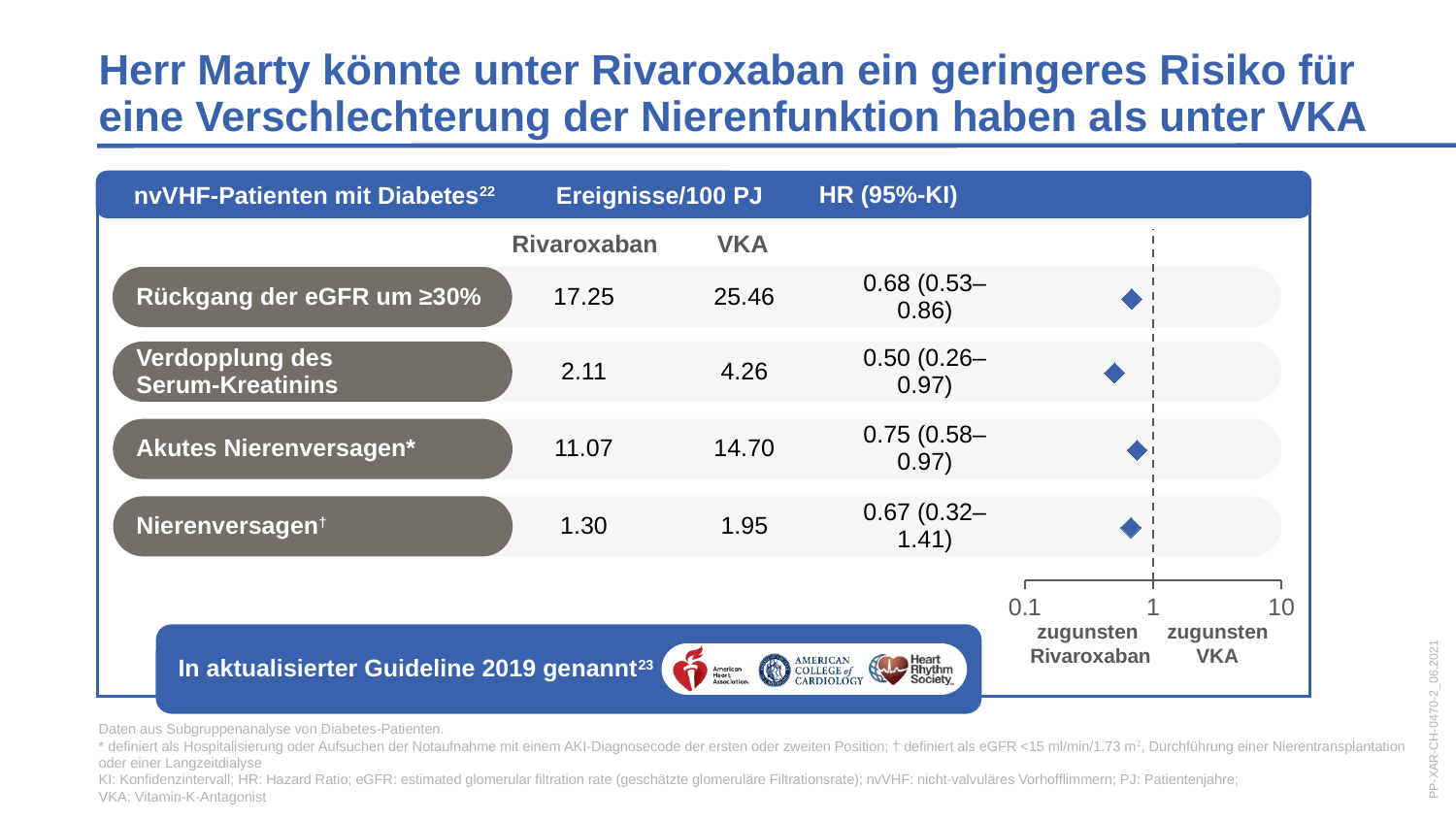
For "Nierenversagen†", which treatment has the higher event rate per 100 PJ, Rivaroxaban or VKA? VKA Which side of the forest plot axis is labelled "zugunsten Rivaroxaban", the left or the right? left Which outcome has the highest hazard ratio in the forest plot? Akutes Nierenversagen* Which outcome has the lowest hazard ratio in the forest plot? Verdopplung des Serum-Kreatinins How many Ereignisse/100 PJ are shown for Rivaroxaban in the row "Akutes Nierenversagen*"? 11.07 For "Rückgang der eGFR um ≥30%", how much higher is the VKA event rate than the Rivaroxaban event rate (Ereignisse/100 PJ)? 8.21 For "Akutes Nierenversagen*", what is the difference between the VKA and Rivaroxaban event rates (Ereignisse/100 PJ)? 3.63 What is the HR (95%-KI) for "Nierenversagen†"? 0.67 (0.32–1.41) How many outcomes (rows) are plotted in the forest plot? 4 Is the hazard ratio point for "Nierenversagen†" plotted greater or less than 1? less What is the VKA value (Ereignisse/100 PJ) for "Verdopplung des Serum-Kreatinins"? 4.26 What is the HR (95%-KI) shown for "Rückgang der eGFR um ≥30%"? 0.68 (0.53–0.86)